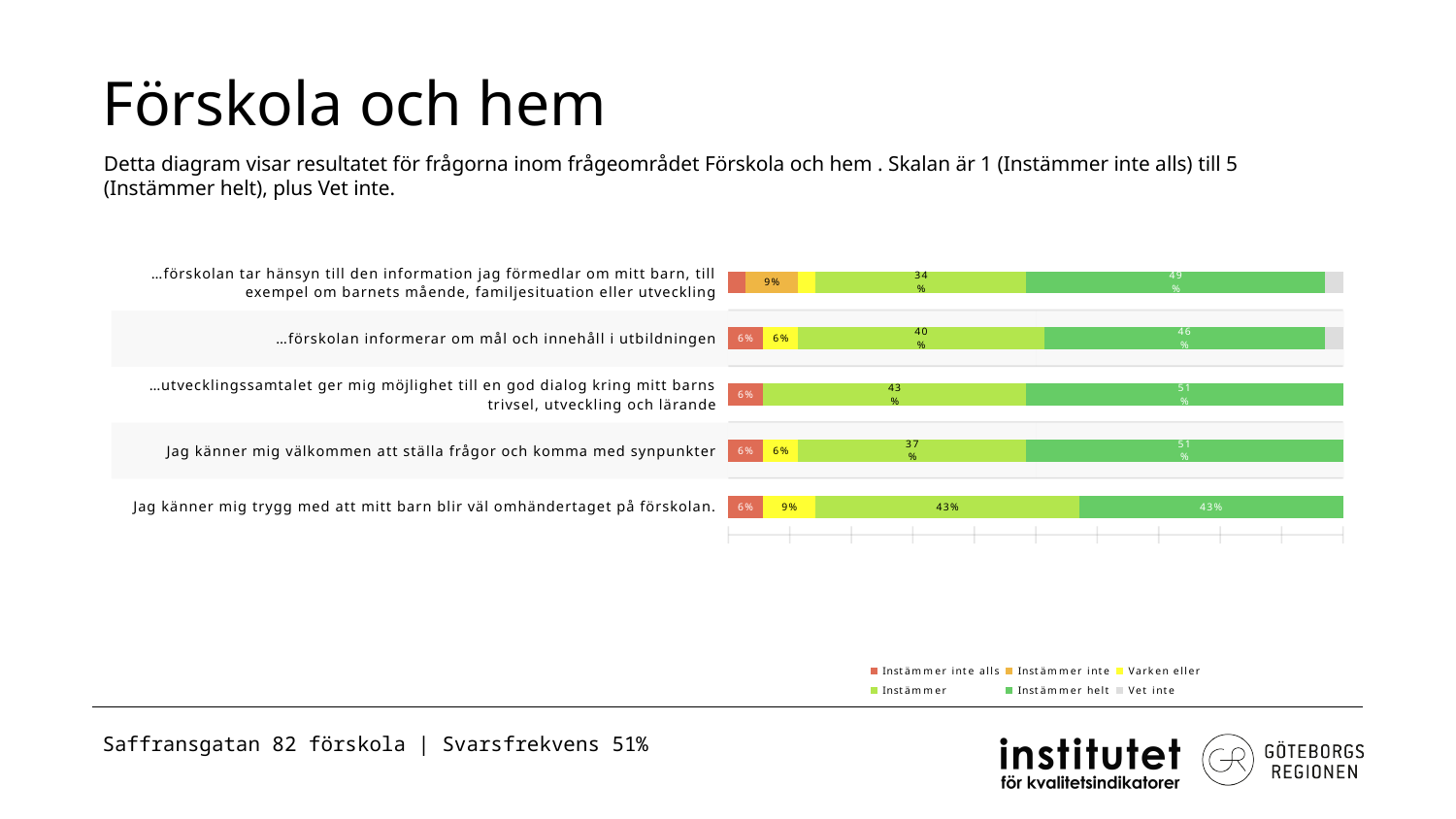
What is the title of the slide containing the chart? Förskola och hem How many statements (categories) are plotted in the chart? 5 What kind of chart is shown on the slide? Stacked bar chart For '…förskolan tar hänsyn till den information jag förmedlar om mitt barn…', how many percentage points larger is the 'Instämmer helt' share than the 'Instämmer' share? 15 percentage points How many series does the chart legend list? 6 What is the 'Instämmer' share for '…förskolan informerar om mål och innehåll i utbildningen'? 40% What is the 'Instämmer' share for 'Jag känner mig välkommen att ställa frågor och komma med synpunkter'? 37% What is the 'Instämmer helt' share for '…utvecklingssamtalet ger mig möjlighet till en god dialog kring mitt barns trivsel, utveckling och lärande'? 51% Which has the larger 'Instämmer helt' share: '…förskolan informerar om mål och innehåll i utbildningen' or 'Jag känner mig välkommen att ställa frågor och komma med synpunkter'? Jag känner mig välkommen att ställa frågor och komma med synpunkter Which statement has the lowest 'Instämmer' share? …förskolan tar hänsyn till den information jag förmedlar om mitt barn, till exempel om barnets mående, familjesituation eller utveckling What is the 'Instämmer helt' share for 'Jag känner mig trygg med att mitt barn blir väl omhändertaget på förskolan'? 43% Which statement has the lowest 'Instämmer helt' share? Jag känner mig trygg med att mitt barn blir väl omhändertaget på förskolan